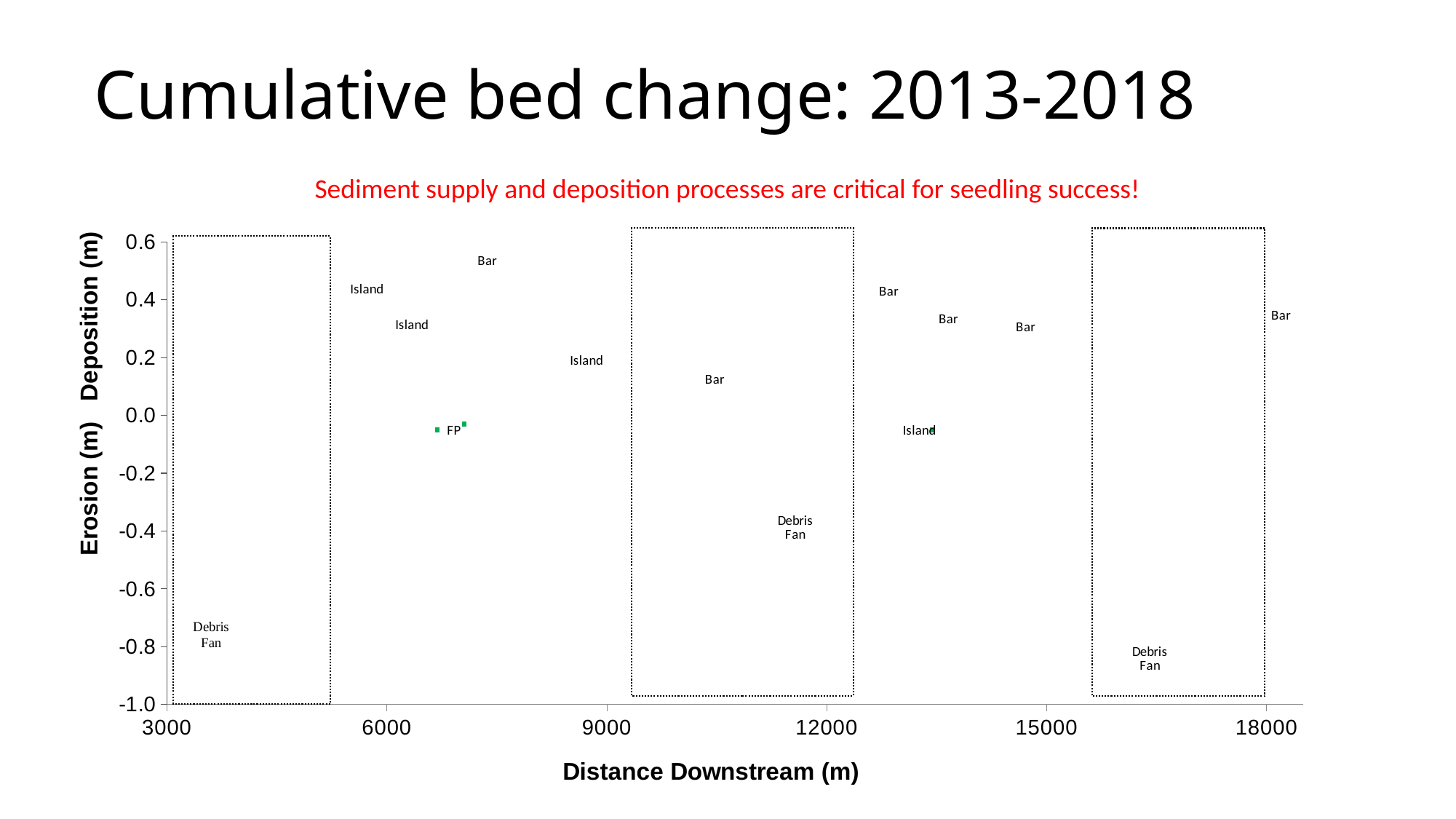
How many points are labelled "Bar" on the chart? 6 How many points are labelled "Island" on the chart? 4 Is the value for the "Debris Fan" label located near 11000 m downstream greater or less than -0.2? less What is the title of the chart on the slide? Cumulative bed change: 2013-2018 What is the label of the x axis? Distance Downstream (m) How many points are labelled "Debris Fan" on the chart? 3 Which is higher on the chart: the "Bar" label near 7000 m downstream or the "Bar" label near 10500 m downstream? the Bar near 7000 m What kind of chart is shown on the slide? scatter chart Is the value for the "Debris Fan" label located near 3500 m downstream greater or less than -0.6? less